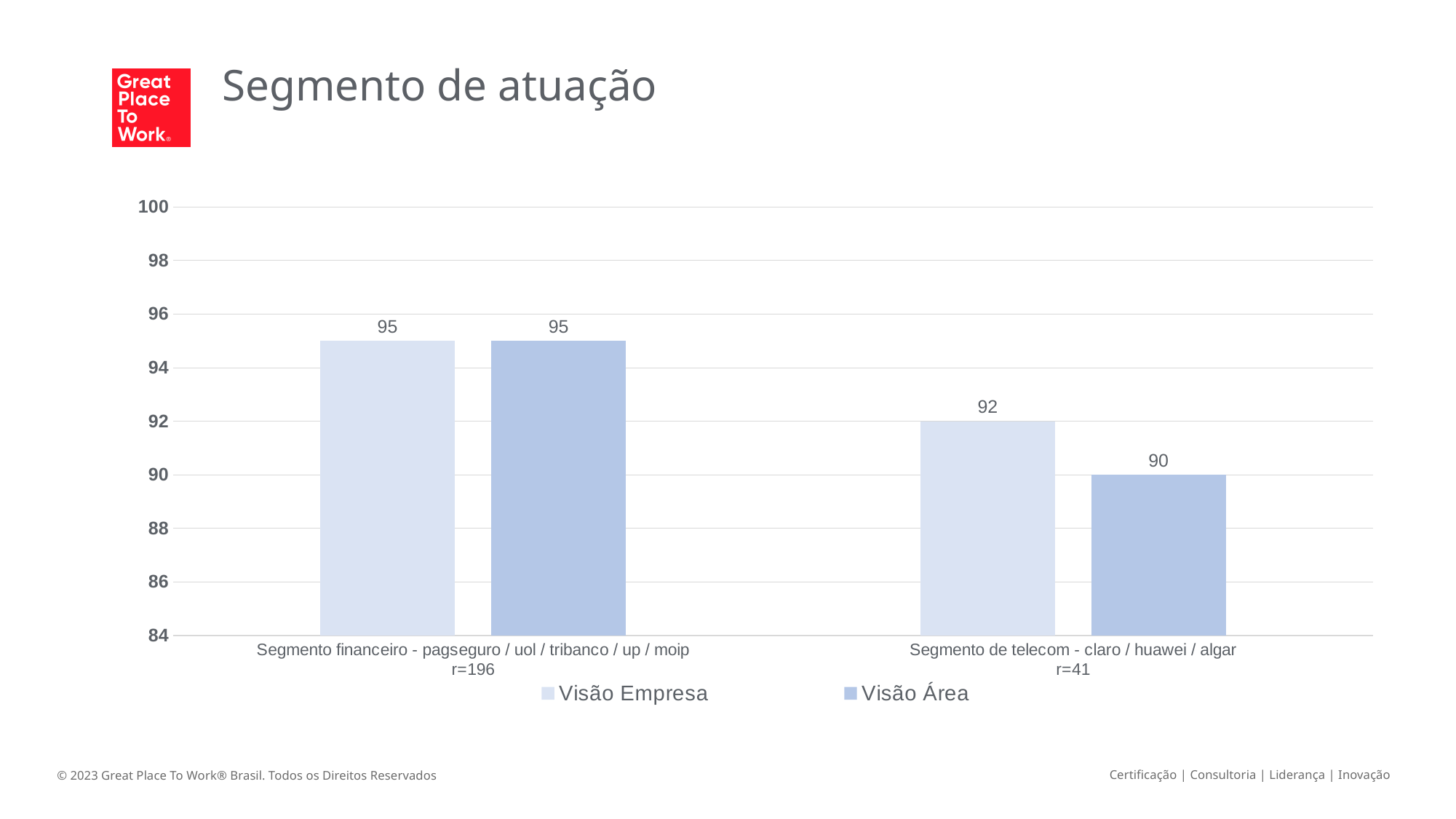
What is the Visão Área value for Segmento de telecom - claro / huawei / algar? 90 What is the difference between the Visão Empresa values for Segmento financeiro and Segmento de telecom? 3 What is the difference between the Visão Empresa and Visão Área values for Segmento de telecom - claro / huawei / algar? 2 How many categories are shown on the x axis? 2 Which category has the highest Visão Empresa value? Segmento financeiro - pagseguro / uol / tribanco / up / moip Which is larger for Segmento de telecom - claro / huawei / algar: Visão Empresa or Visão Área? Visão Empresa What is the Visão Empresa value for Segmento de telecom - claro / huawei / algar? 92 What kind of chart is shown on the slide? Bar chart What is the Visão Área value for Segmento financeiro - pagseguro / uol / tribanco / up / moip? 95 Which category has the lowest Visão Área value? Segmento de telecom - claro / huawei / algar What is the Visão Empresa value for Segmento financeiro - pagseguro / uol / tribanco / up / moip? 95 How many series does the legend list? 2